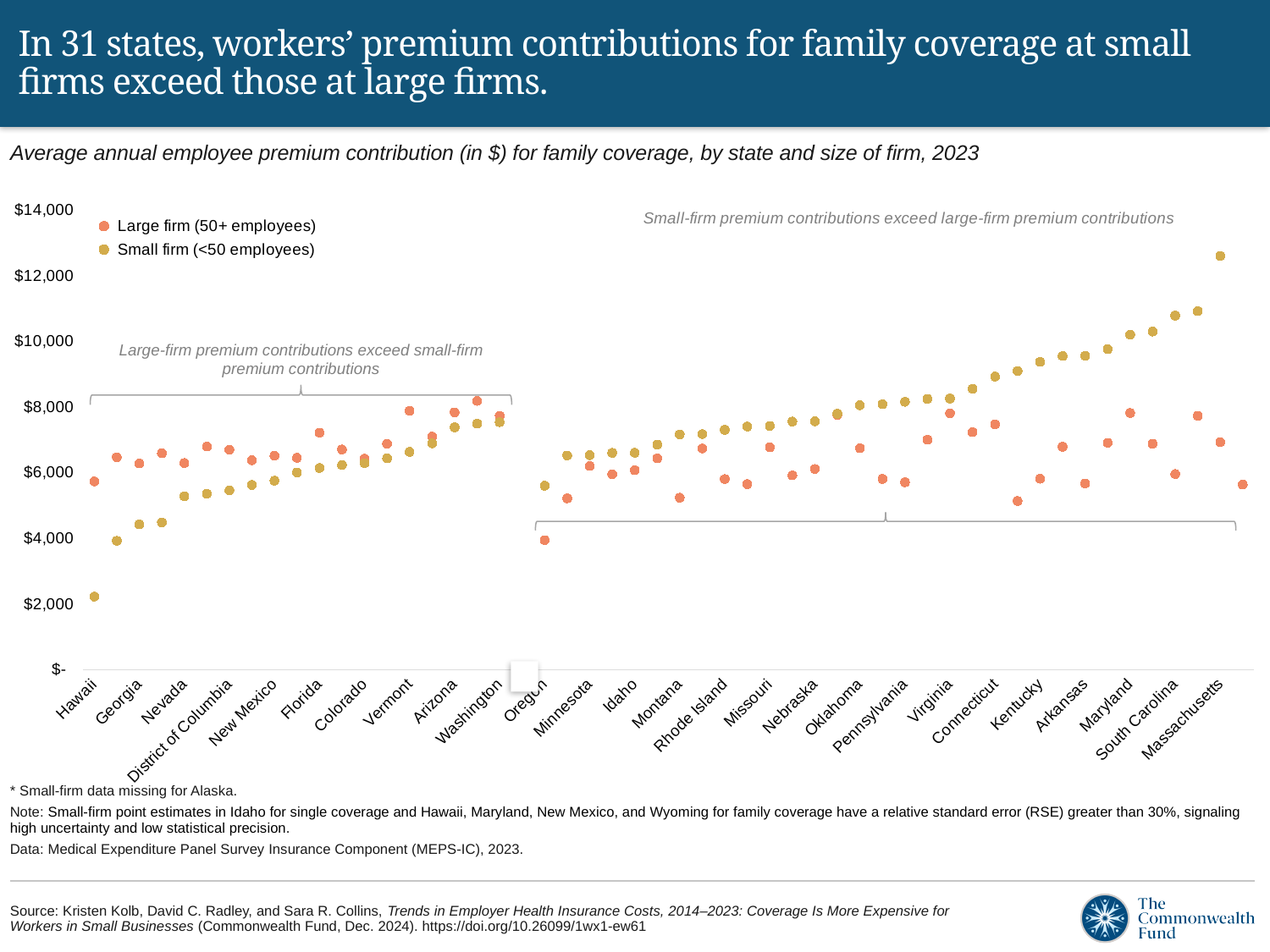
Is the small-firm value for Maryland greater or less than $8,000? greater What kind of chart is this? Scatter (dot) chart For Hawaii, which is larger: the large-firm or the small-firm premium contribution? Large firm Is the small-firm value for Hawaii greater or less than $4,000? less Which state has the highest small-firm premium contribution? Massachusetts For Massachusetts, which is larger: the large-firm or the small-firm premium contribution? Small firm Which state has the lowest small-firm premium contribution? Hawaii What year does the chart's data refer to? 2023 How many series does the legend list? 2 What are the two legend entries of the chart? Large firm (50+ employees); Small firm (<50 employees) Is the small-firm value for Massachusetts greater or less than $12,000? greater